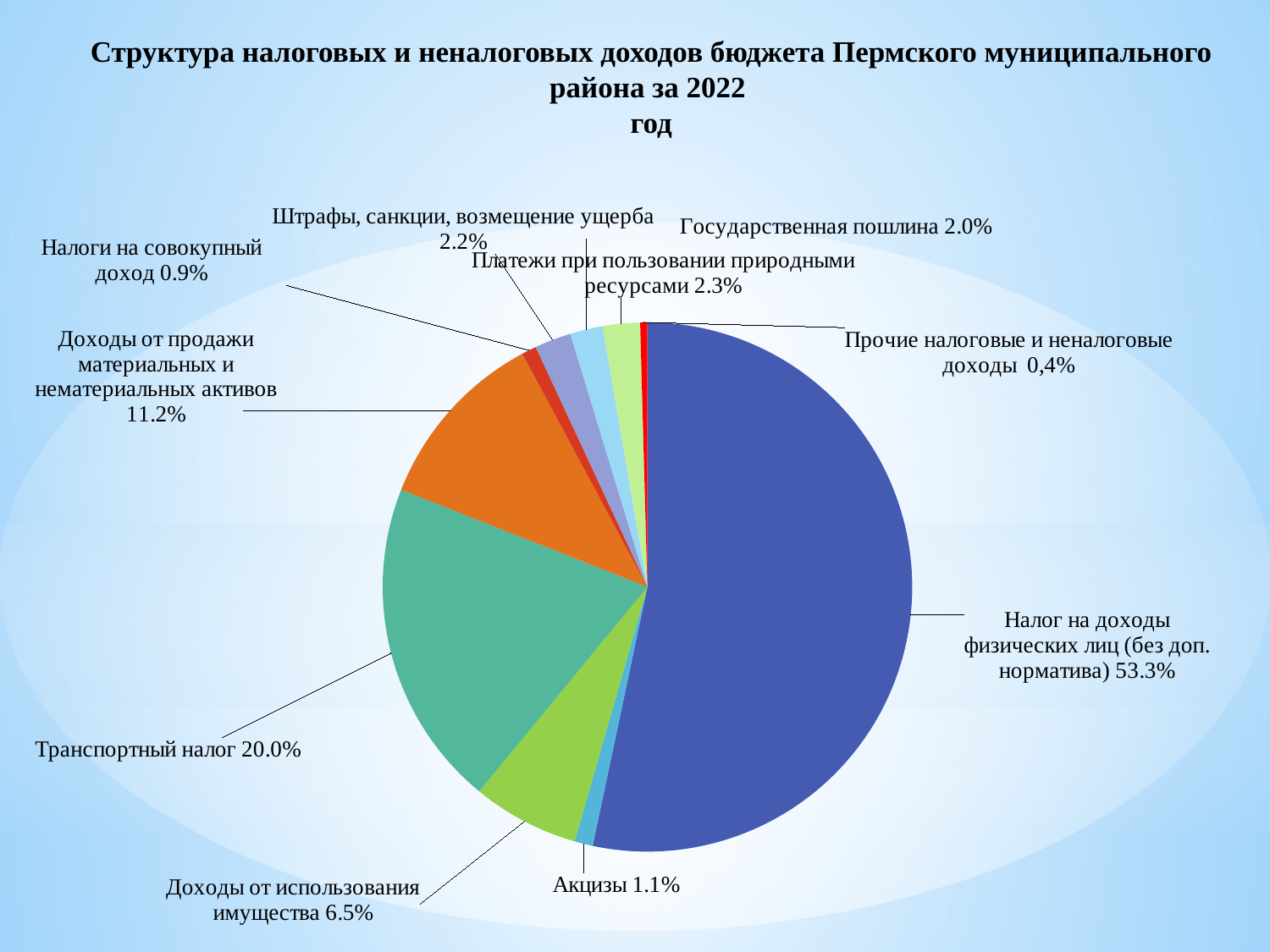
What kind of chart is shown on the slide? pie chart What share of the budget revenue is Транспортный налог? 20.0% Which is larger: Платежи при пользовании природными ресурсами or Штрафы, санкции, возмещение ущерба? Платежи при пользовании природными ресурсами What share is shown for Государственная пошлина? 2.0% What year does the chart title refer to? 2022 What is the difference between the shares of Транспортный налог and Доходы от использования имущества? 13.5% What share is shown for Акцизы? 1.1% How many slices does the pie chart have? 10 What share is shown for Доходы от использования имущества? 6.5% What share is shown for Доходы от продажи материальных и нематериальных активов? 11.2% Which category has the smallest share of the pie? Прочие налоговые и неналоговые доходы Which category has the largest share of the pie? Налог на доходы физических лиц (без доп. норматива)